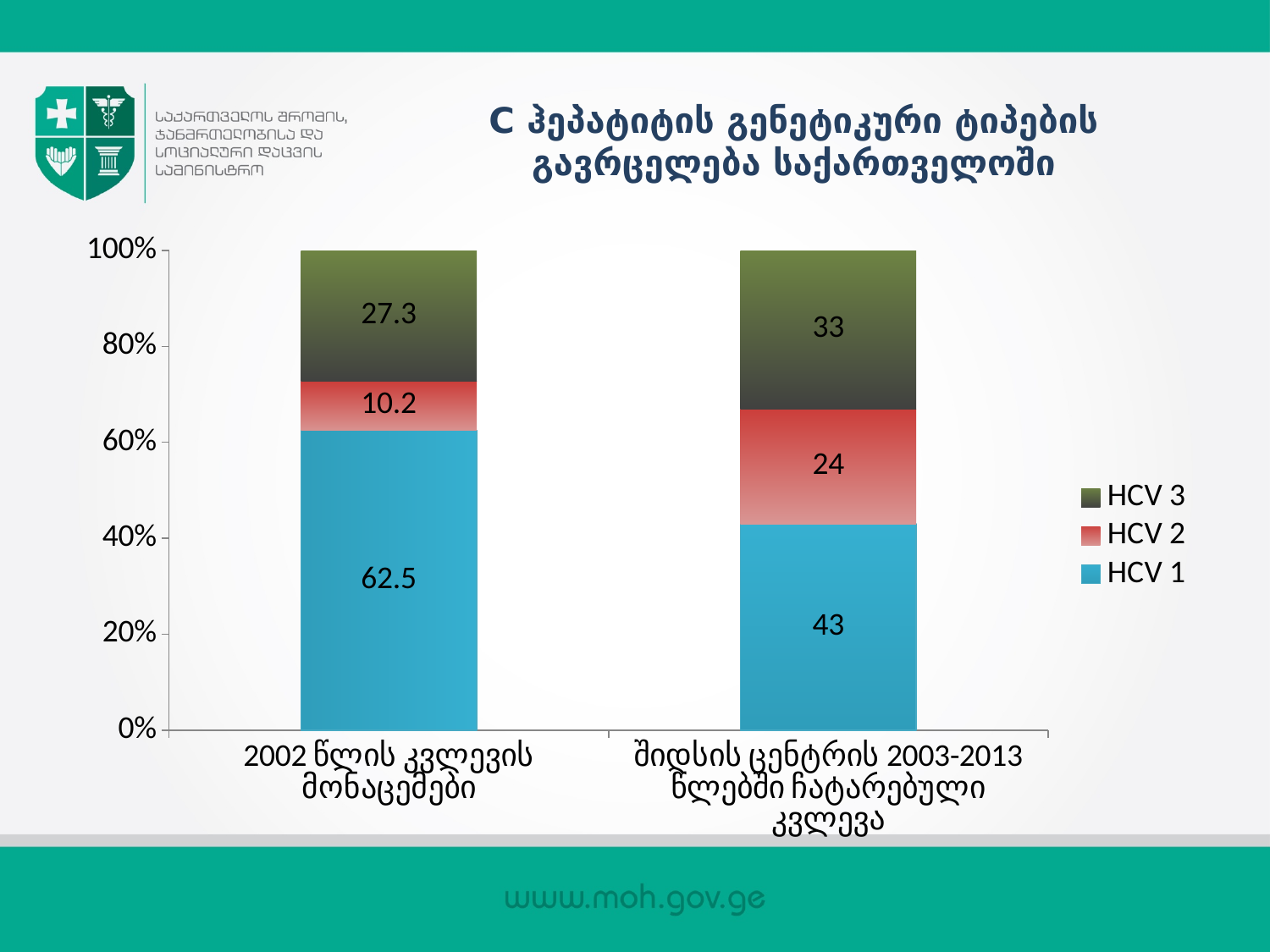
How many categories are shown on the x axis? 2 What is the HCV 3 value for the "შიდსის ცენტრის 2003-2013 წლებში ჩატარებული კვლევა" bar? 33 What is the HCV 2 value for the "2002 წლის კვლევის მონაცემები" bar? 10.2 What is the HCV 1 value for the "2002 წლის კვლევის მონაცემები" bar? 62.5 Which bar has the larger HCV 3 value, "2002 წლის კვლევის მონაცემები" or "შიდსის ცენტრის 2003-2013 წლებში ჩატარებული კვლევა"? შიდსის ცენტრის 2003-2013 წლებში ჩატარებული კვლევა What kind of chart is shown on the slide? Stacked bar chart What is the difference between the HCV 2 values of the two bars (24 and 10.2)? 13.8 Which series has the smallest value in the "შიდსის ცენტრის 2003-2013 წლებში ჩატარებული კვლევა" bar? HCV 2 Which series has the largest value in the "2002 წლის კვლევის მონაცემები" bar? HCV 1 Which legend entry is shown in blue? HCV 1 How many series does the legend list? 3 What is the HCV 1 value for the "შიდსის ცენტრის 2003-2013 წლებში ჩატარებული კვლევა" bar? 43